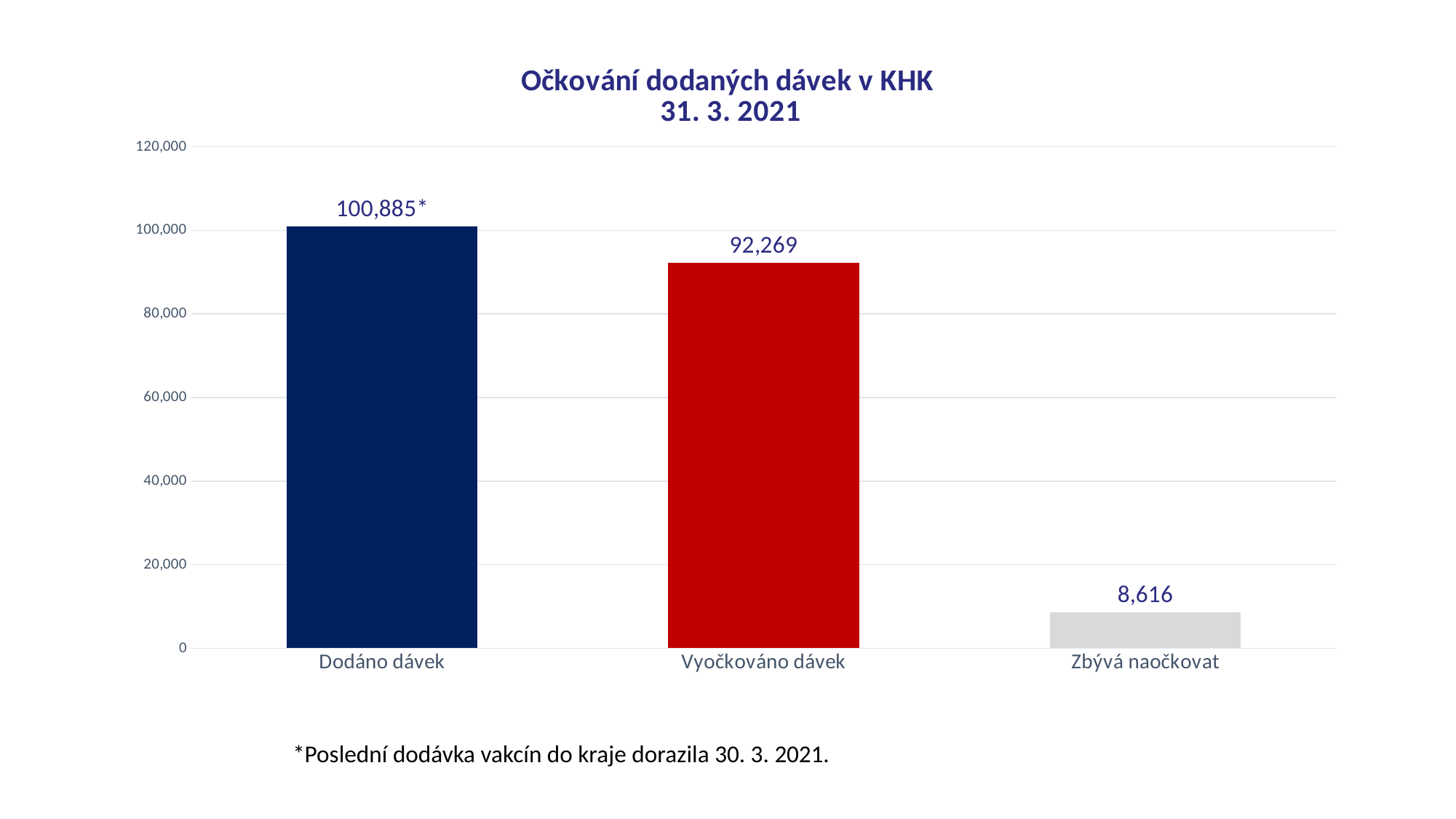
Is the value for Vyočkováno dávek greater or less than 100,000? less Which is larger, Vyočkováno dávek or Zbývá naočkovat? Vyočkováno dávek What kind of chart is shown on the slide? bar chart What is the value for Dodáno dávek? 100,885 Which category has the lowest value? Zbývá naočkovat How many categories are shown in the chart? 3 What is the value for Zbývá naočkovat? 8,616 What is the difference between Vyočkováno dávek and Zbývá naočkovat? 83,653 What is the difference between Dodáno dávek and Vyočkováno dávek? 8,616 Which category has the highest value? Dodáno dávek What is the value for Vyočkováno dávek? 92,269 What is the title of the chart? Očkování dodaných dávek v KHK 31. 3. 2021